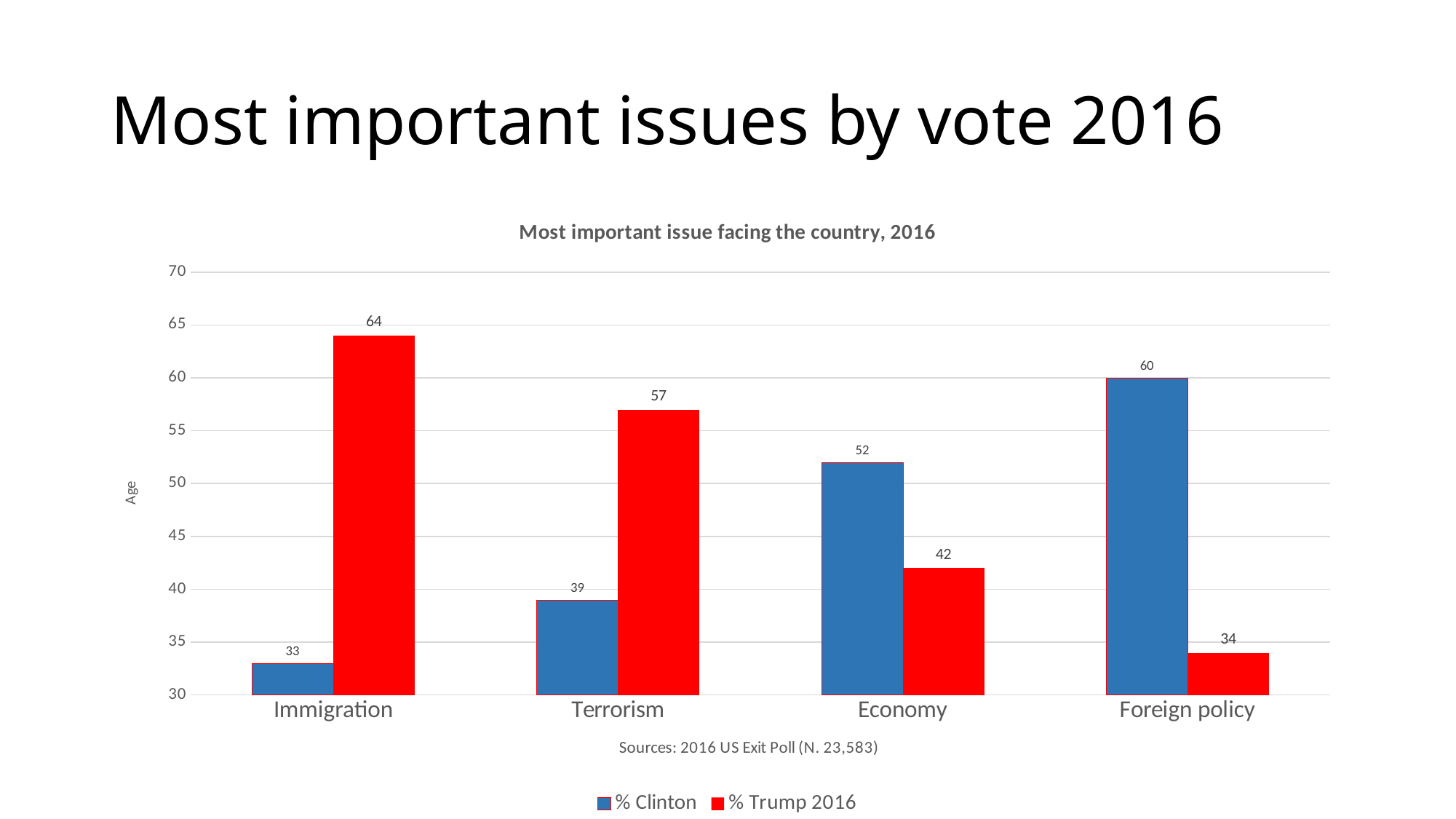
How many issue categories are shown on the x axis? 4 What kind of chart is shown on the slide? Bar chart Is the % Trump 2016 value for Foreign policy greater or less than 40? less What is the % Clinton value for Immigration? 33 What is the % Clinton value for Foreign policy? 60 What is the difference between the % Trump 2016 and % Clinton values for Immigration? 31 What is the % Trump 2016 value for Terrorism? 57 Which issue has the highest % Trump 2016 value? Immigration Which issue has the lowest % Clinton value? Immigration For Economy, which is larger: % Clinton or % Trump 2016? % Clinton How many series does the legend list? 2 What is the title of the chart? Most important issue facing the country, 2016